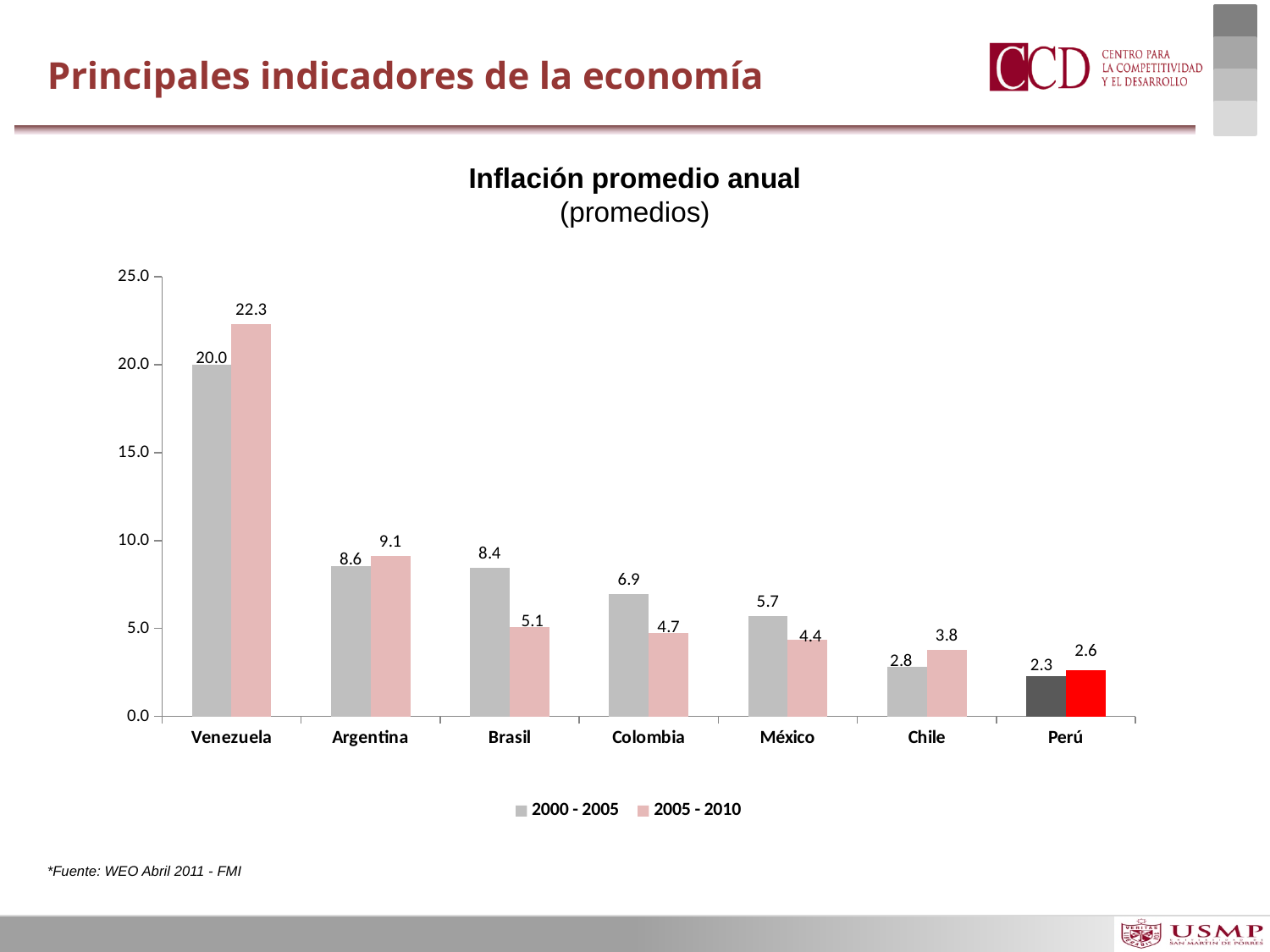
What is the value for Perú in the 2005 - 2010 series? 2.6 Which country has the lowest value in the 2005 - 2010 series? Perú Is the value for Colombia in the 2000 - 2005 series greater or less than 5.0? greater What is the value for Venezuela in the 2005 - 2010 series? 22.3 What kind of chart is shown on the slide? Bar chart What is the difference between the 2000 - 2005 and 2005 - 2010 values for Brasil? 3.3 What is the value for Brasil in the 2000 - 2005 series? 8.4 Which is larger for Chile: the 2000 - 2005 value or the 2005 - 2010 value? 2005 - 2010 How many series does the legend list? 2 How many countries are shown on the x axis? 7 Which country has the highest value in the 2000 - 2005 series? Venezuela What is the difference between the 2005 - 2010 and 2000 - 2005 values for Venezuela? 2.3